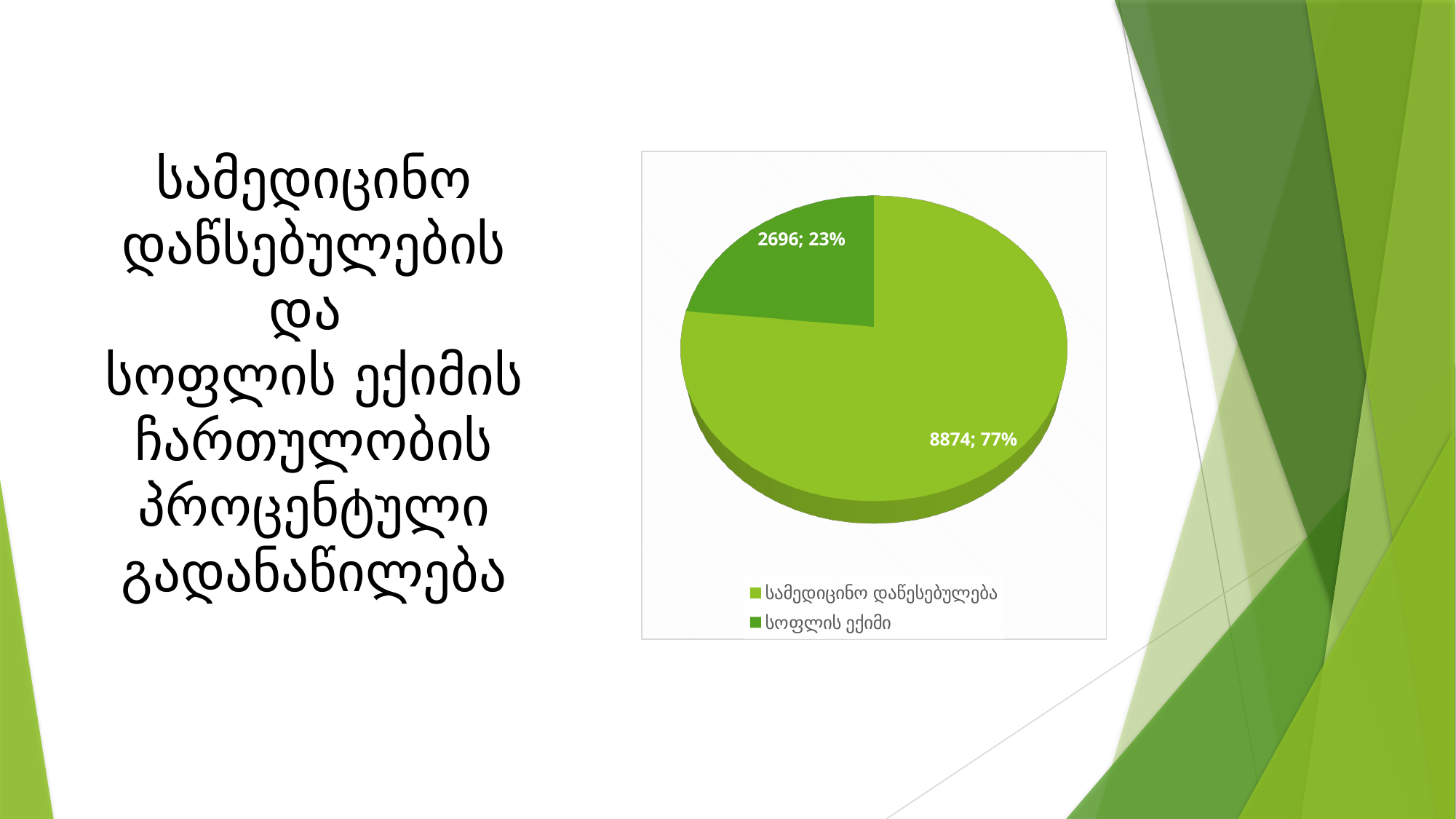
What percentage share does the სოფლის ექიმი slice have? 23% What percentage share does the სამედიცინო დაწესებულება slice have? 77% Which slice of the pie chart is the smallest? სოფლის ექიმი What value is shown for the სამედიცინო დაწესებულება slice? 8874 How many slices does the pie chart have? 2 What kind of chart is shown on the slide? pie chart What is the total of the two values shown in the pie chart? 11570 Which slice of the pie chart is the largest? სამედიცინო დაწესებულება Which is larger, the value for სამედიცინო დაწესებულება or the value for სოფლის ექიმი? სამედიცინო დაწესებულება What is the difference between the values for სამედიცინო დაწესებულება and სოფლის ექიმი? 6178 What value is shown for the სოფლის ექიმი slice? 2696 How many entries does the legend of the pie chart list? 2